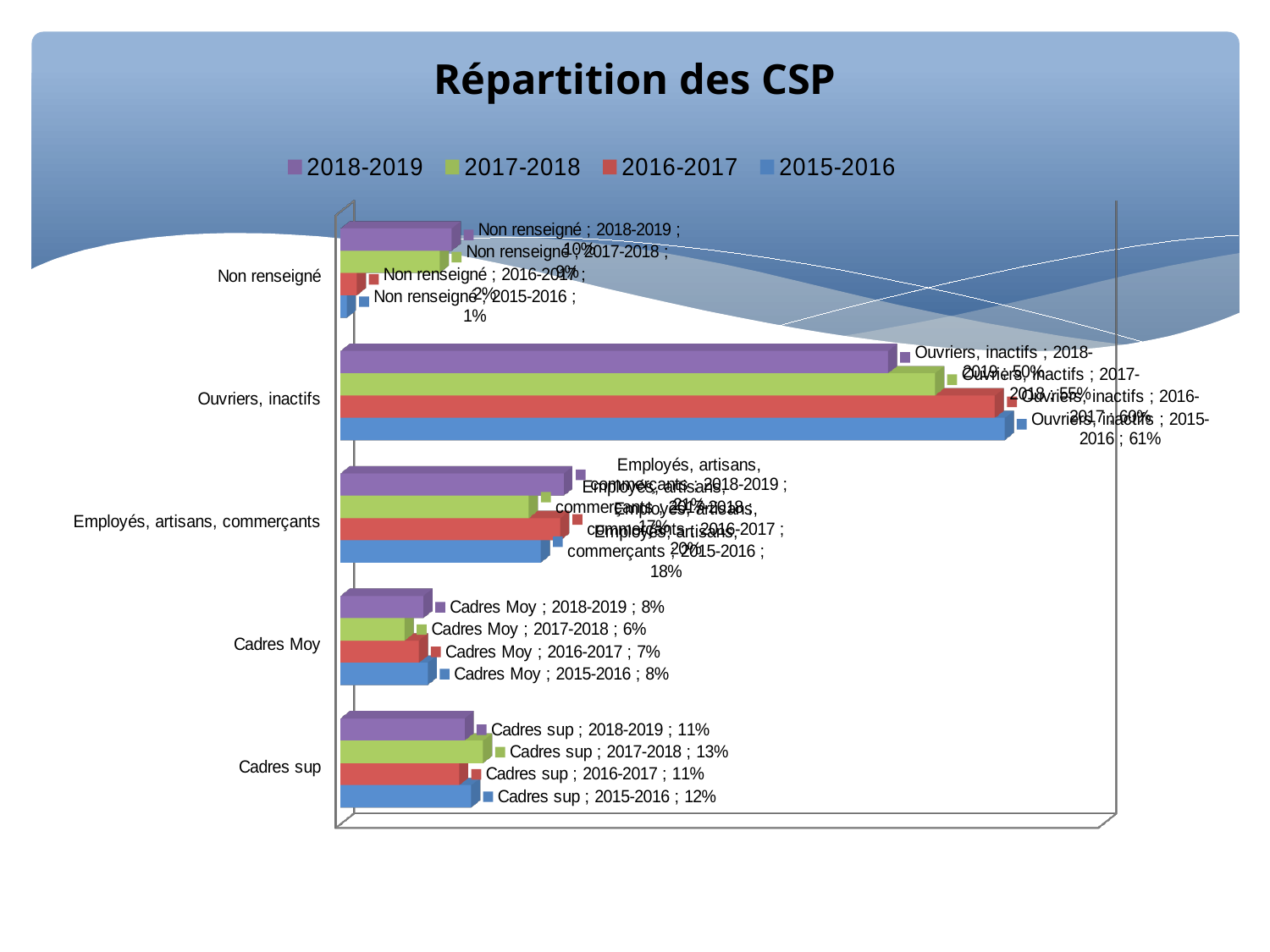
What is the value for Cadres sup in 2017-2018? 13% Which category has the highest value in 2018-2019? Ouvriers, inactifs How many categories are shown on the chart? 5 What kind of chart is shown on the slide? bar chart Which category has the lowest value in 2015-2016? Non renseigné Which is larger for Cadres Moy: the 2018-2019 value or the 2017-2018 value? 2018-2019 What is the title of the chart? Répartition des CSP What is the difference between the Cadres sup values for 2017-2018 and 2018-2019? 2% What is the value for Cadres Moy in 2016-2017? 7% What is the value for Non renseigné in 2015-2016? 1% What is the value for Ouvriers, inactifs in 2015-2016? 61% How many series does the legend list? 4